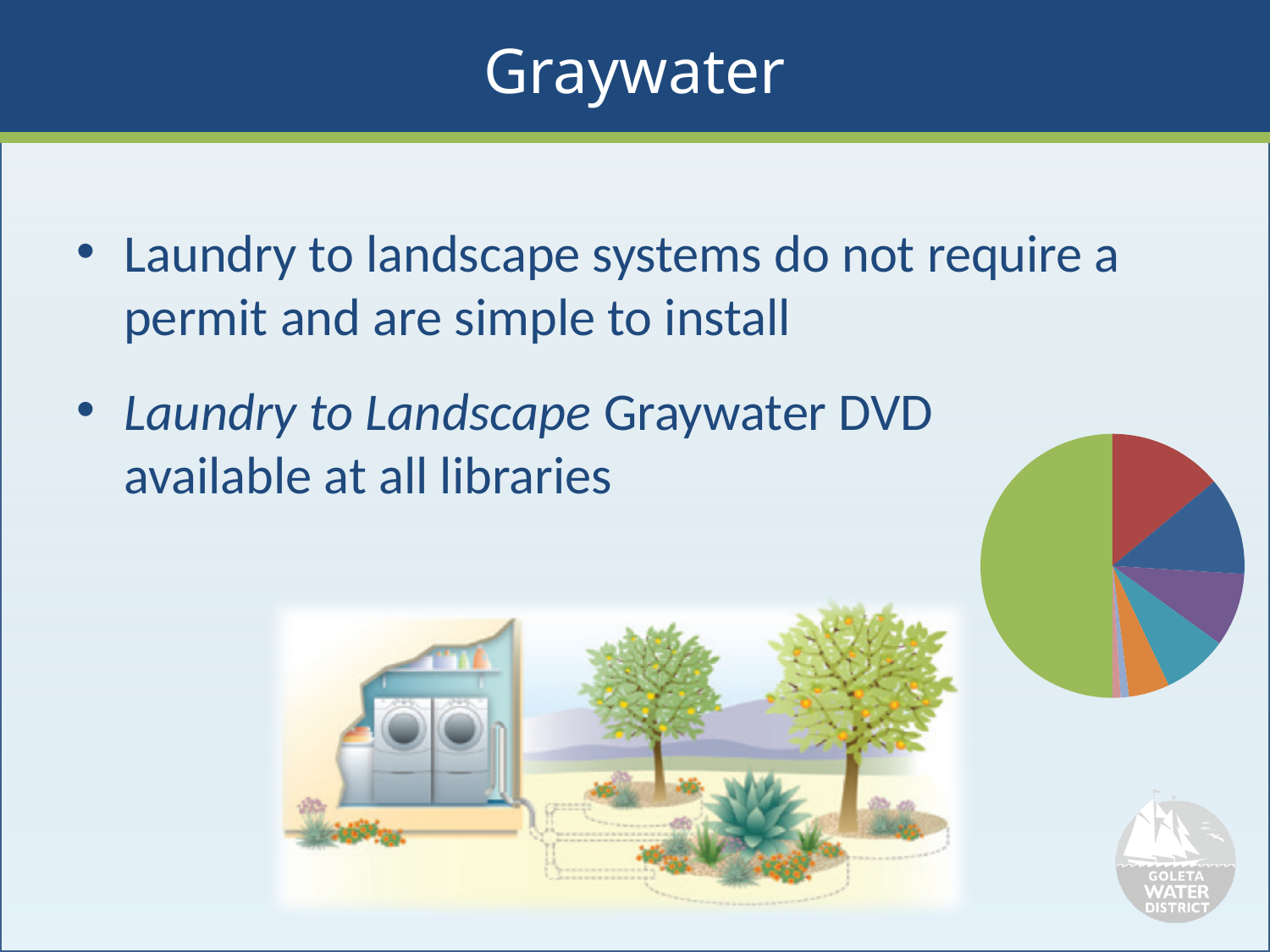
Does the pie chart have a legend? No Which colour slice is the largest in the pie chart? green In the pie chart, which is larger, the dark blue slice or the teal slice? dark blue Does the pie chart display data labels on its slices? No In the pie chart, which is larger, the green slice or the red slice? green What kind of chart is shown on the right side of the slide? pie chart In the pie chart, which is larger, the red slice or the orange slice? red